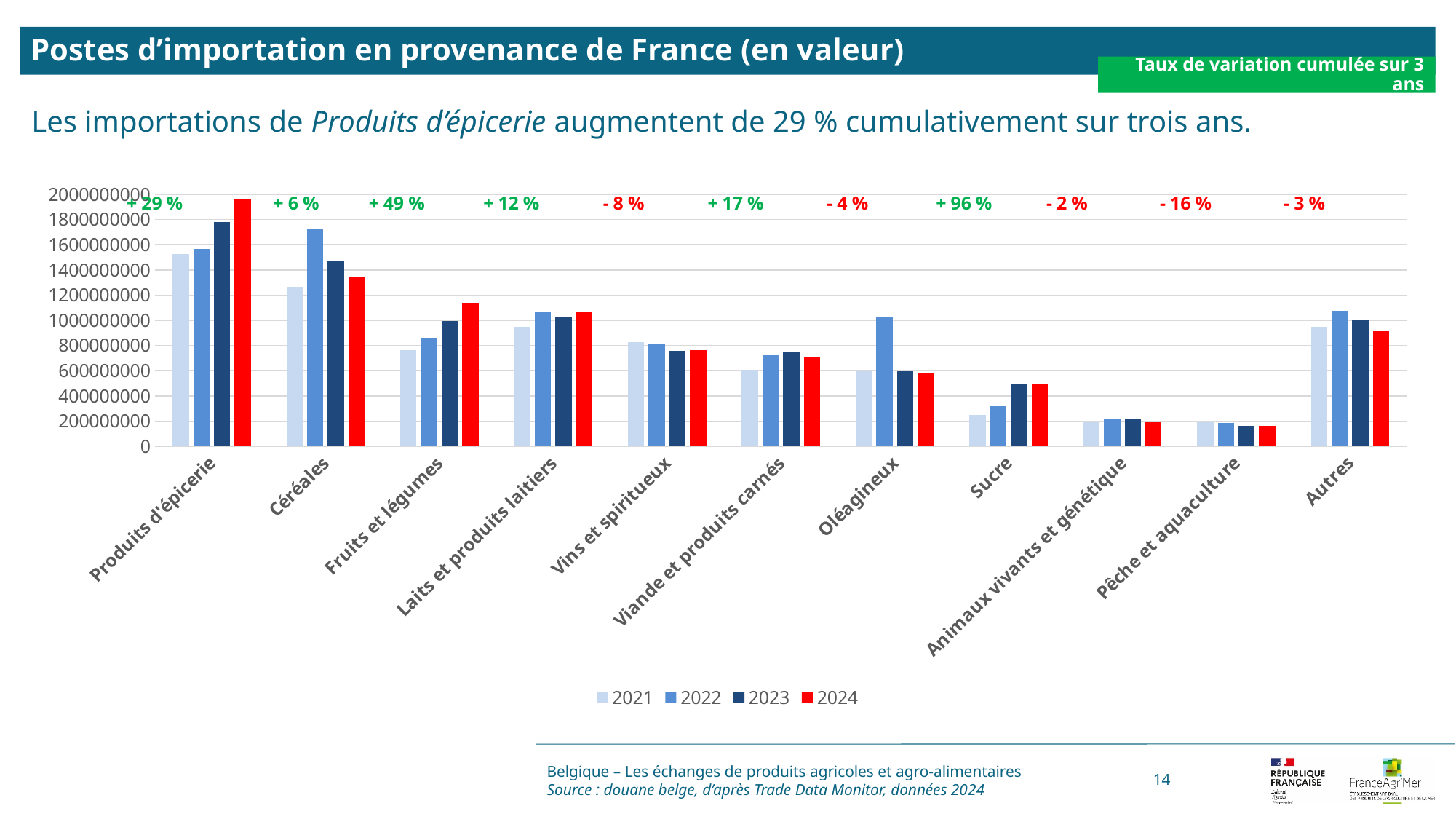
How many series does the legend list? 4 What is the cumulative 3-year variation rate printed above Sucre? + 96 % Which category has the lowest cumulative 3-year variation rate? Pêche et aquaculture What is the cumulative 3-year variation rate printed above Pêche et aquaculture? - 16 % What kind of chart is shown on the slide? Bar chart Is the 2024 value for Sucre greater or less than 600000000? less Which category has the highest 2024 bar? Produits d'épicerie Is the 2024 value for Produits d'épicerie greater or less than 1800000000? greater Which category has the highest cumulative 3-year variation rate? Sucre Which is larger in 2024: Céréales or Fruits et légumes? Céréales What is the cumulative 3-year variation rate printed above Fruits et légumes? + 49 % How many product categories are shown on the x axis? 11